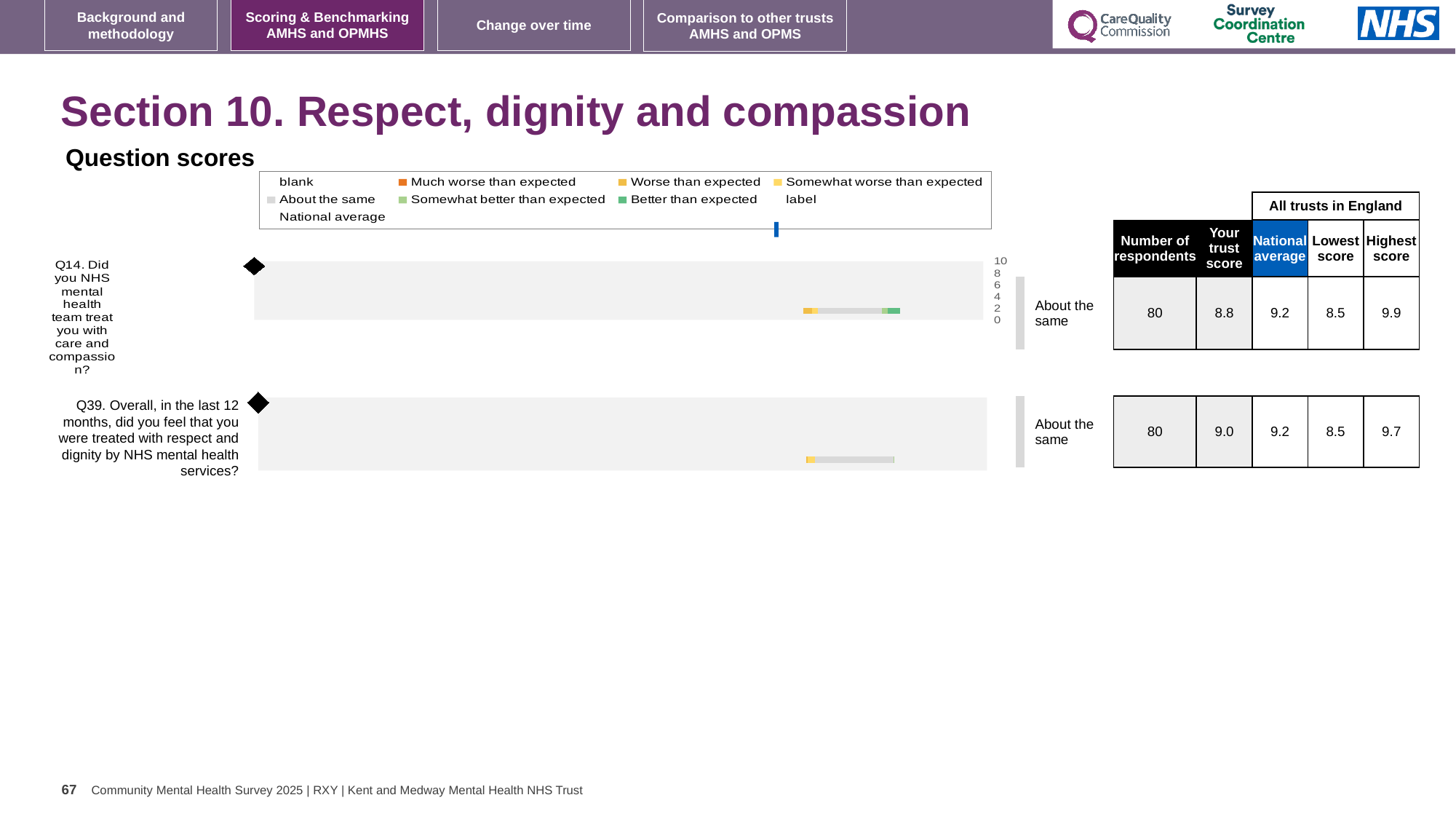
What is the trust score for Q39 (respect and dignity) shown in the table next to the chart? 9.0 What is the national average for Q14 shown in the table? 9.2 What is the lowest score among all trusts in England for Q14? 8.5 What is the title of the chart section above the chart? Question scores What benchmark category is shown for Q14 next to the chart? About the same What is the highest score among all trusts in England for Q39? 9.7 Which question has the higher trust score, Q14 or Q39? Q39 What is the difference between the highest and lowest scores for Q39? 1.2 How many questions are plotted in the chart? 2 How many respondents answered Q39? 80 What is the difference between the national average and the trust score for Q14? 0.4 What is the trust score for Q14 (care and compassion) shown in the table next to the chart? 8.8